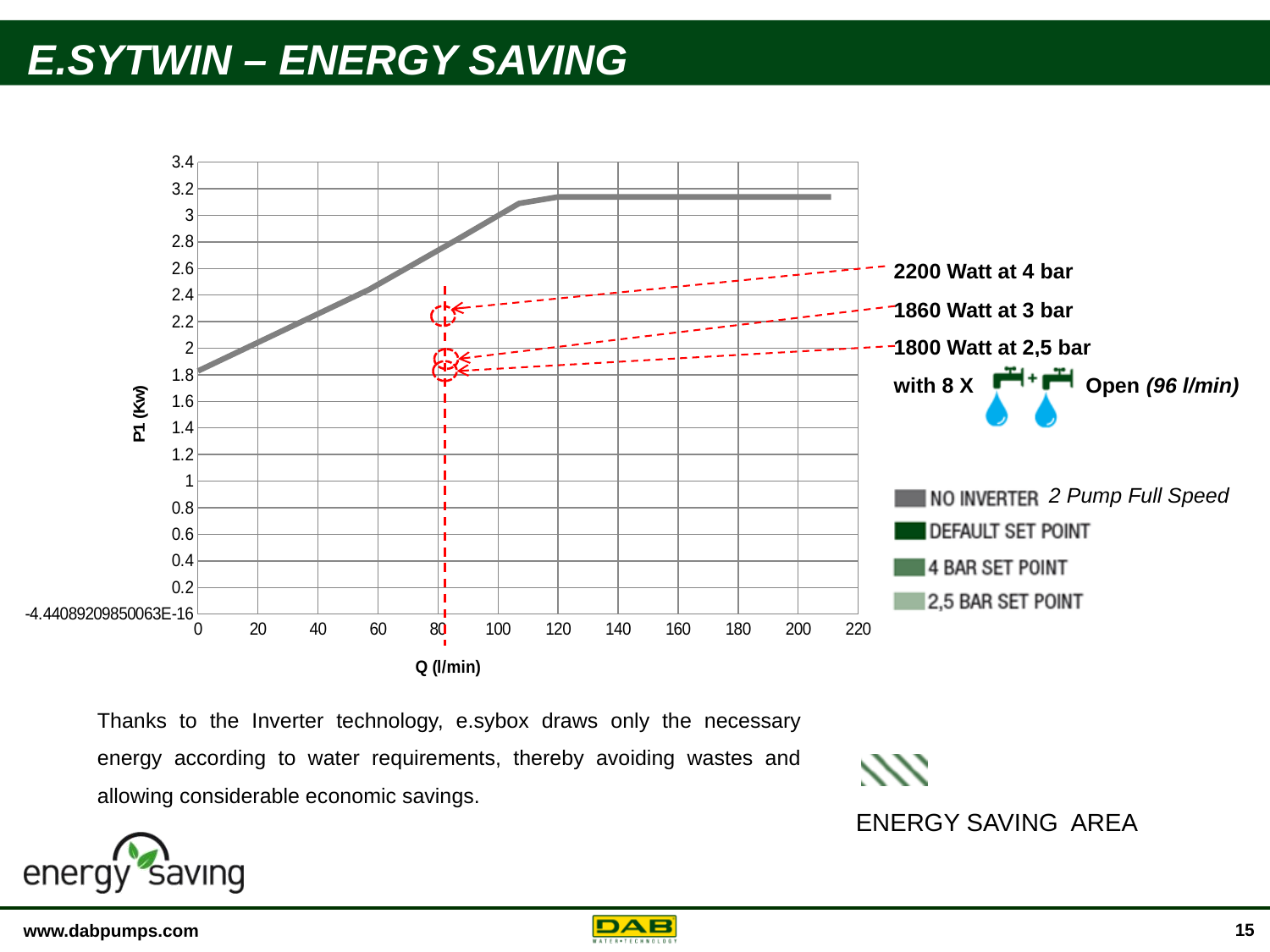
What is the label of the chart's y axis? P1 (Kw) How many entries does the chart legend list? 4 Which annotated set point draws more power, 3 bar or 2,5 bar? 3 bar According to the annotation, how much power is drawn at 4 bar? 2200 Watt Is the value of the NO INVERTER line at Q = 0 greater or less than 2? less According to the annotation, how much power is drawn at 2,5 bar? 1800 Watt Is the value of the NO INVERTER line at Q = 60 greater or less than 2.2? greater What is the difference between the power at 4 bar and the power at 2,5 bar shown in the annotations? 400 Watt What is the label of the chart's x axis? Q (l/min) What kind of chart is shown on the slide? line chart Is the value of the NO INVERTER line at Q = 200 greater or less than 3? greater Does the NO INVERTER line rise or fall as Q increases from 0 to 100 l/min? rise